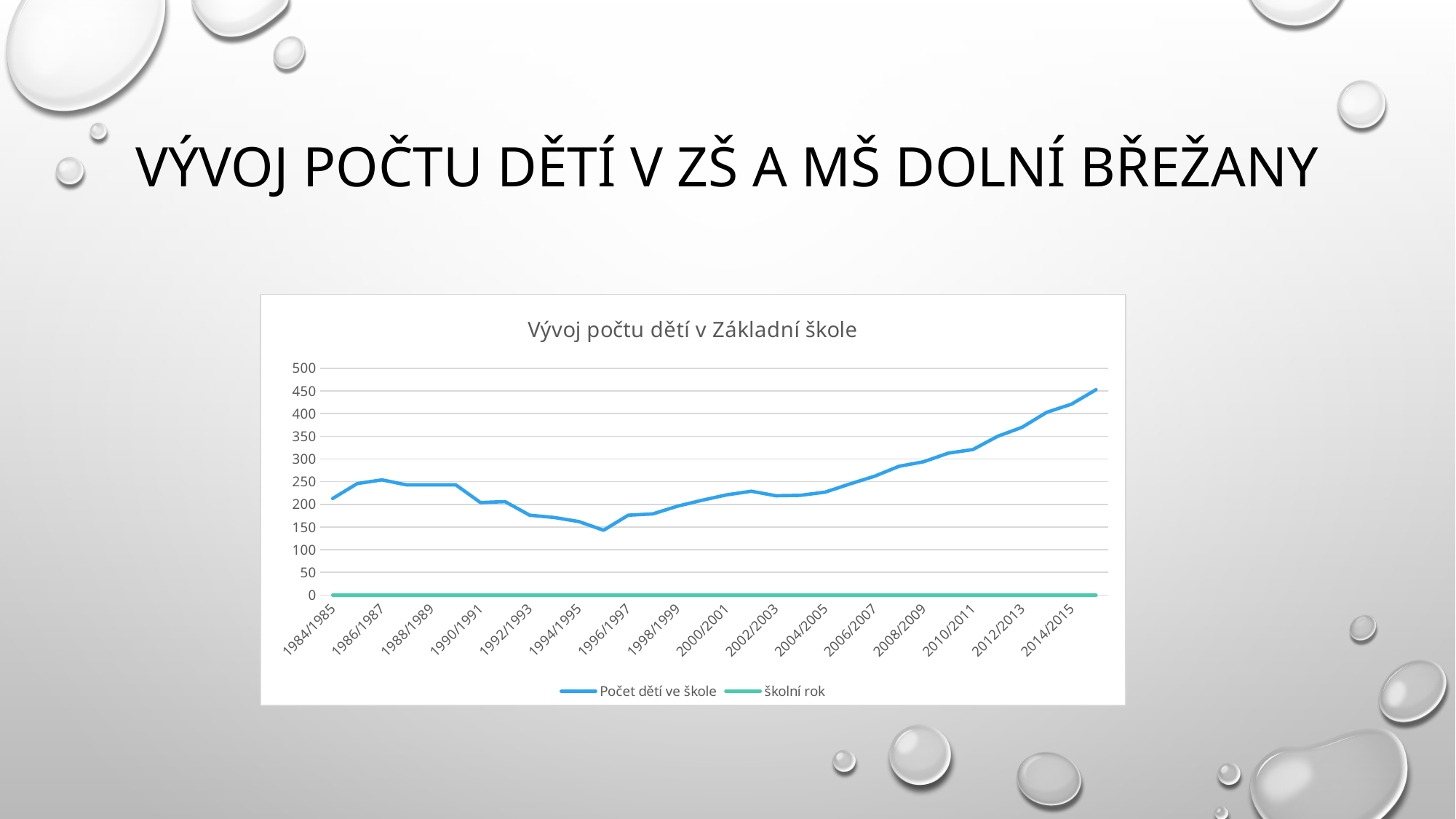
What is the title of the chart? Vývoj počtu dětí v Základní škole Is the value for Počet dětí ve škole in 2010/2011 greater or less than 300? greater How many series does the chart legend list? 2 Is the value for Počet dětí ve škole in 2012/2013 greater or less than 400? less How many school-year labels are shown on the x axis? 16 Is the value for Počet dětí ve škole in 1994/1995 greater or less than 200? less Does the Počet dětí ve škole line rise or fall between 1996/1997 and 2014/2015? rise What kind of chart is shown on the slide? line chart Which is larger, the value for Počet dětí ve škole in 2014/2015 or in 1984/1985? 2014/2015 What are the two series named in the legend? Počet dětí ve škole, školní rok